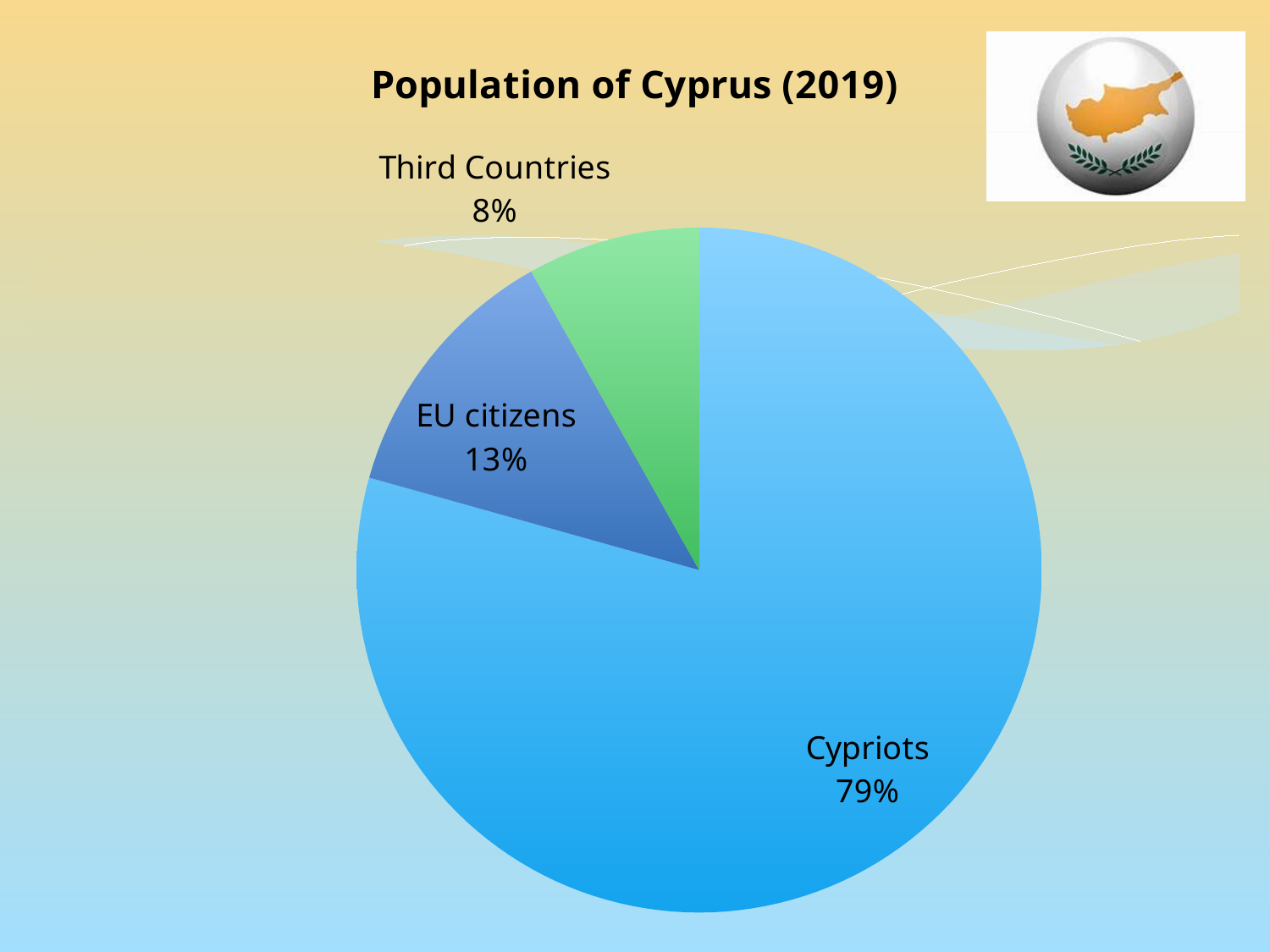
What is the title of the chart? Population of Cyprus (2019) Which is larger, the share of EU citizens or the share of Third Countries? EU citizens What is the difference in percentage points between the Cypriots share and the EU citizens share? 66 What colour is the Third Countries slice? Green What kind of chart is shown on the slide? Pie chart How many slices does the pie chart have? 3 Which group makes up the largest share of the population of Cyprus (2019)? Cypriots What share of the population of Cyprus (2019) is EU citizens? 13% What is the difference in percentage points between the EU citizens share and the Third Countries share? 5 Which group makes up the smallest share of the population of Cyprus (2019)? Third Countries What share of the population of Cyprus (2019) is from Third Countries? 8% What share of the population of Cyprus (2019) is Cypriots? 79%